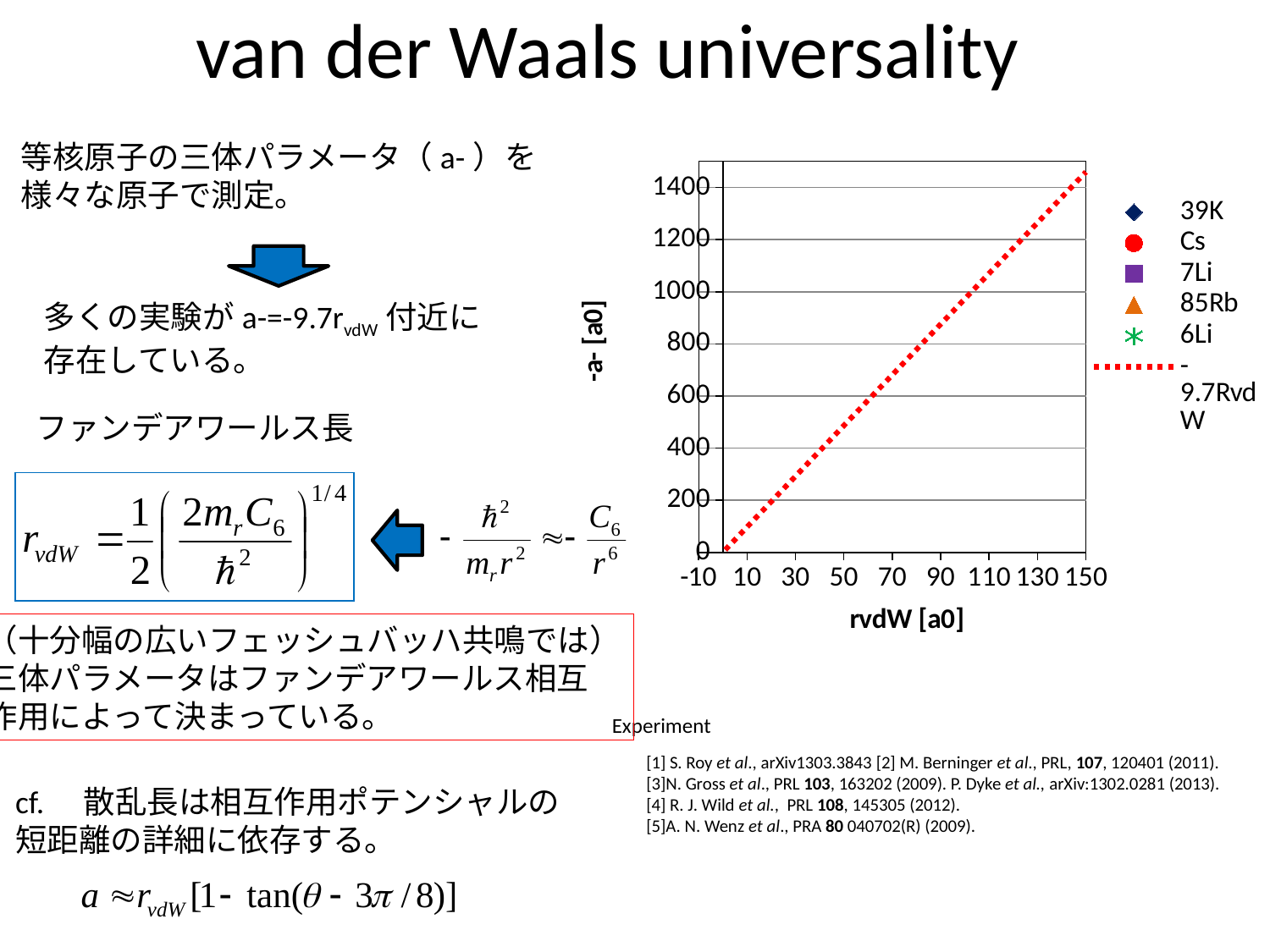
Is the value of the -9.7RvdW line at rvdW = 50 greater or less than 600? less Does the dotted -9.7RvdW line rise or fall as rvdW increases? rises Is the value of the -9.7RvdW line at rvdW = 100 greater or less than 800? greater Is the value of the -9.7RvdW line at rvdW = 100 greater or less than 1200? less Which legend entry is drawn as a red dotted line? -9.7RvdW How many tick labels are shown on the x axis of the chart? 9 What is the highest tick value shown on the y axis of the chart? 1400 How many entries does the chart legend list? 6 What kind of chart is shown on the slide? scatter chart with a dotted line What is the label of the x axis of the chart? rvdW [a0]